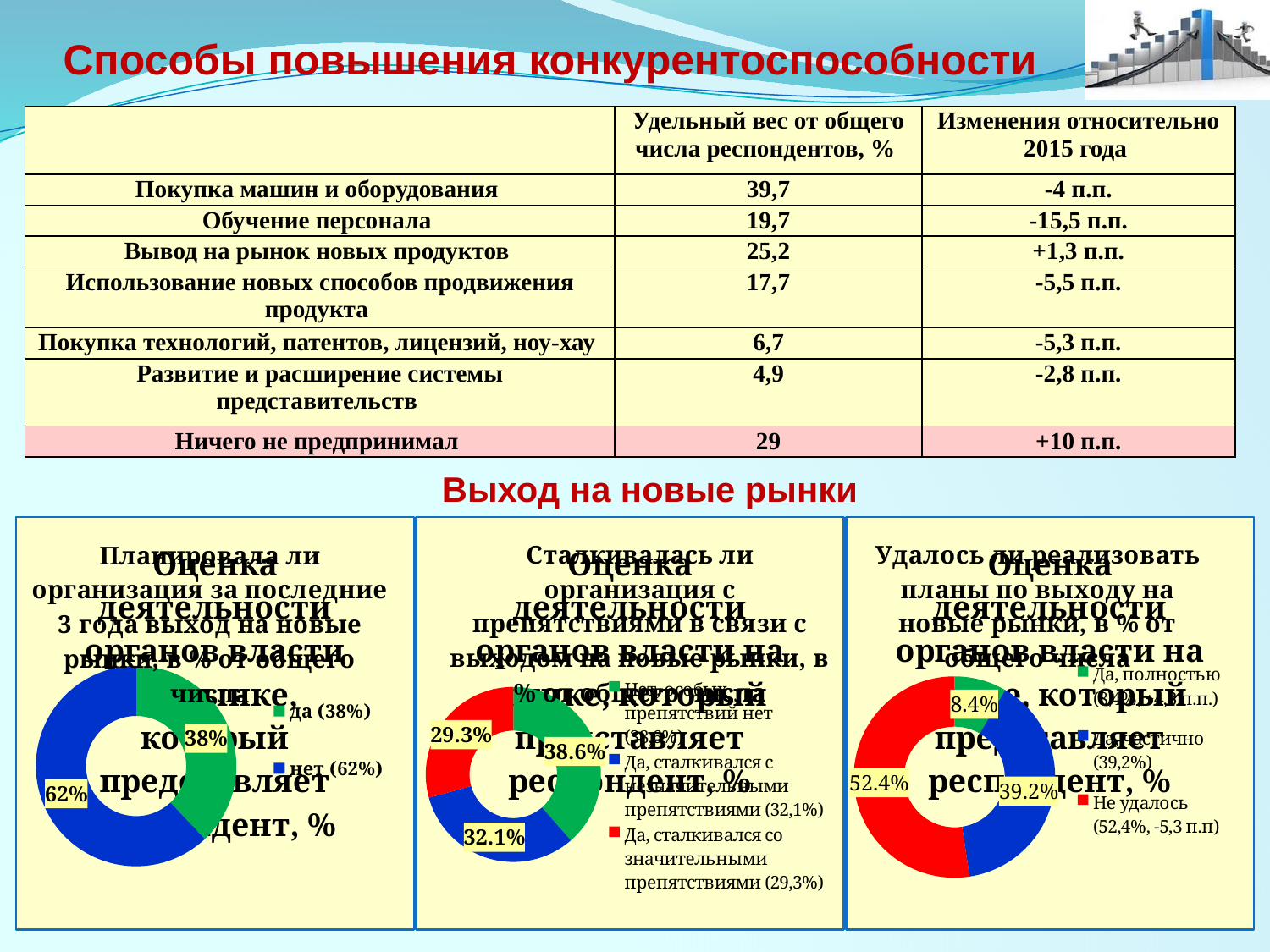
In the right chart, which category has the largest share? Не удалось In the right chart, what share of respondents answered 'Не удалось' (did not succeed)? 52.4% In the left chart, what share of respondents answered 'нет' (no)? 62% In the middle chart, which category has the smallest share? Да, сталкивался со значительными препятствиями In the left chart, what is the difference between the 'нет' share and the 'да' share? 24% How many categories does the legend of the middle chart list? 3 What type of chart is the right chart? doughnut (pie) chart In the left chart, what share of respondents answered 'да' (yes)? 38% In the left chart, which answer has the larger share, 'да' or 'нет'? нет In the middle chart, what share of respondents faced significant obstacles ('значительными препятствиями')? 29.3% How many slices does the left chart have? 2 In the middle chart, what share of respondents reported no particular obstacles ('Нет особых препятствий')? 38.6%